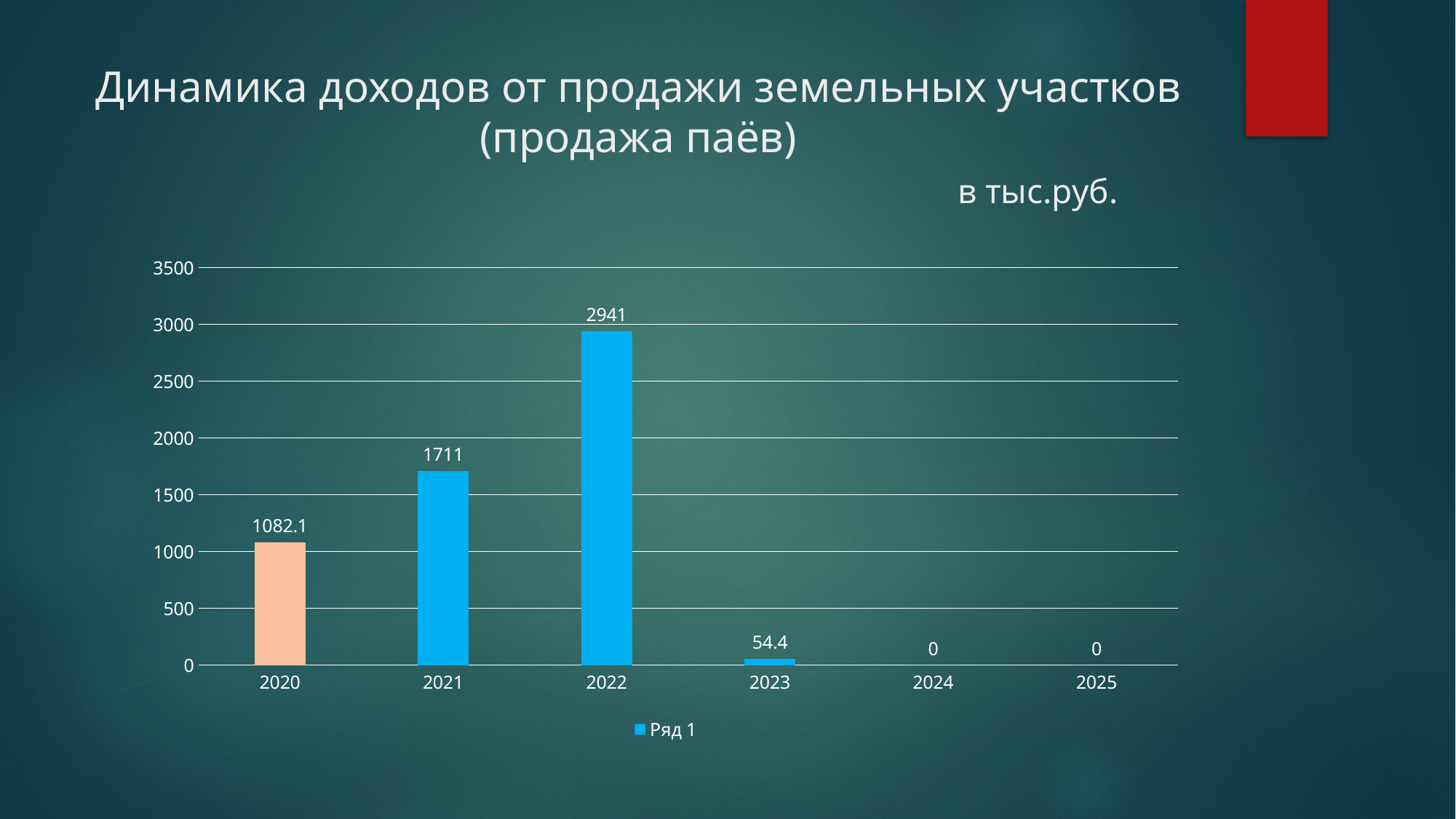
Which is larger, the value for 2021 or the value for 2020? 2021 What is the value for 2023? 54.4 What is the value for 2020? 1082.1 What kind of chart is shown on the slide? bar chart What is the value for 2024? 0 What is the value for 2022? 2941 Is the value for 2021 greater or less than 1500? greater What is the name of the series in the legend? Ряд 1 What is the difference between the values for 2022 and 2021? 1230 How many years are shown on the x axis? 6 How many series does the legend list? 1 Which year has the highest value? 2022